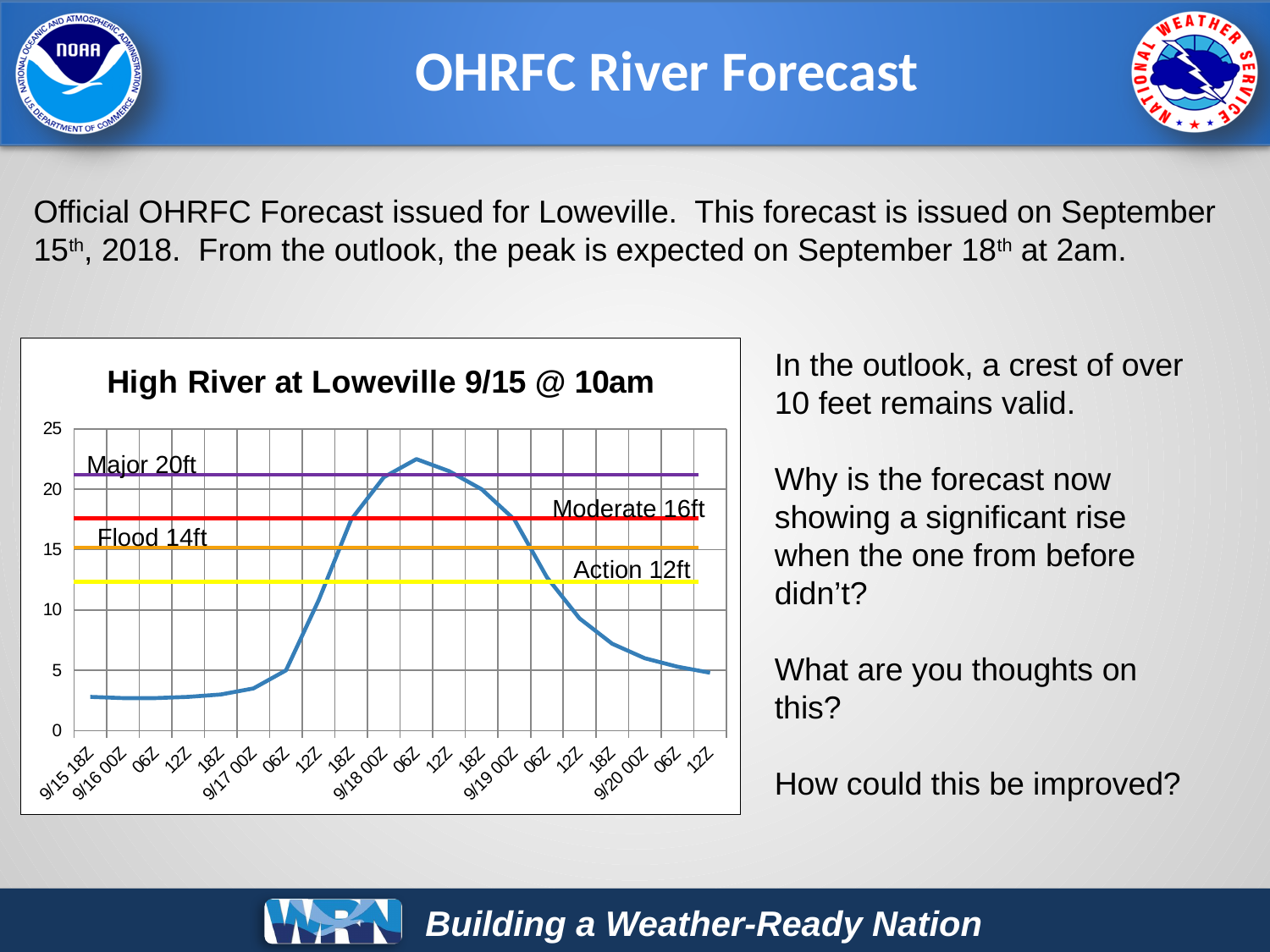
How many time labels are shown along the x axis? 20 What stage value is labeled for the Major flood reference line? 20ft Is the river stage at 9/17 18Z greater or less than 15? greater What is the title of the chart? High River at Loweville 9/15 @ 10am Is the river stage at 9/15 18Z greater or less than 5? less What type of chart is shown on the slide? line chart Does the river stage rise or fall between 9/17 00Z and 9/18 06Z? rise Does the river stage rise or fall between 9/18 06Z and 9/20 12Z? fall At which x-axis time does the river stage reach its highest value? 9/18 06Z Is the peak river stage at 9/18 06Z greater or less than 20? greater What stage value is labeled for the Action reference line? 12ft